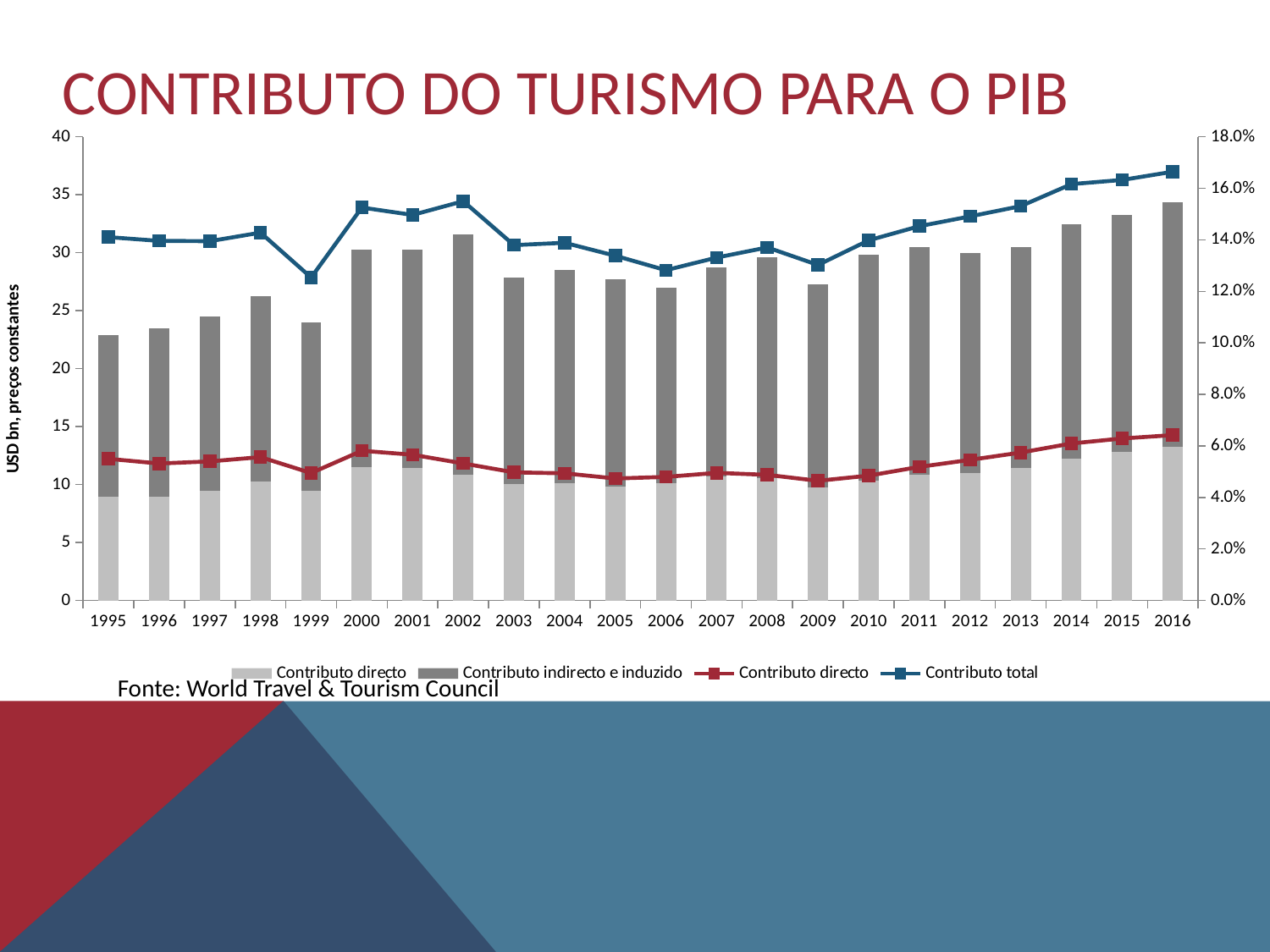
Is the 'Contributo total' line value for 1999 greater or less than 14.0%? less Is the 'Contributo directo' line value for 2009 greater or less than 6.0%? less What is the title of the chart on the slide? CONTRIBUTO DO TURISMO PARA O PIB Is the total height of the stacked bar for 1995 greater or less than 25? less How many series does the chart legend list? 4 Which year has the taller stacked bar, 2002 or 2003? 2002 In which year is the stacked bar (total USD bn) the tallest? 2016 Does the 'Contributo total' line rise or fall from 2009 to 2016? rise What kind of chart is shown on the slide? A combination chart with stacked bars and lines In which year does the 'Contributo total' line reach its highest value? 2016 How many years are shown along the x axis of the chart? 22